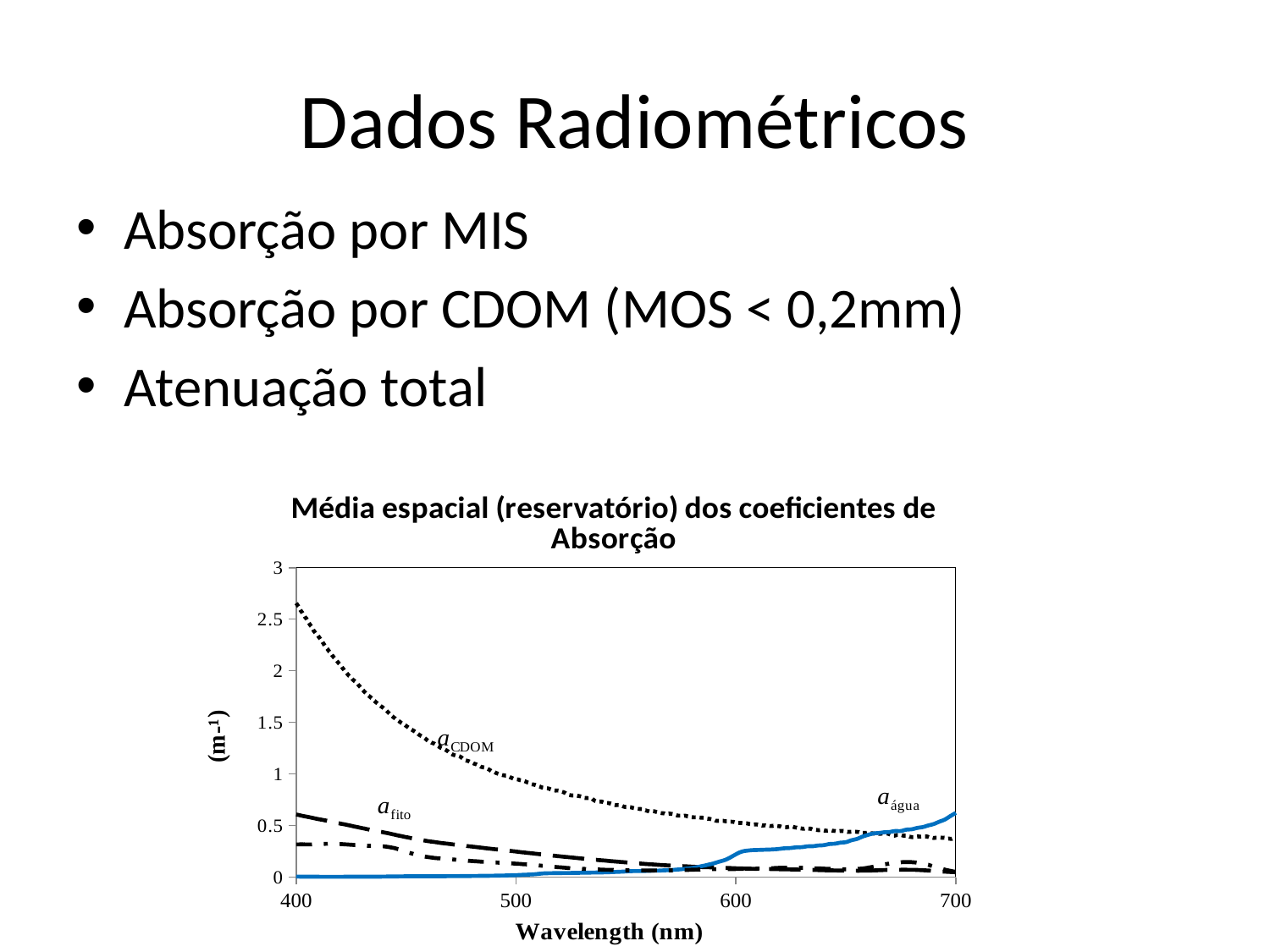
Which series has the highest value at 400 nm? a_CDOM Is the value of a_água at 700 nm greater or less than 0.5? greater What kind of chart is shown on the slide? line chart Is the value of a_CDOM at 400 nm greater or less than 2.5? greater Is the value of a_CDOM at 700 nm greater or less than 0.5? less Which series has the lowest value at 400 nm? a_água What is the title of the chart? Média espacial (reservatório) dos coeficientes de Absorção Does the a_água series rise or fall as wavelength increases from 400 to 700 nm? rise Does the a_CDOM series rise or fall as wavelength increases from 400 to 700 nm? fall What is the label of the x axis of the chart? Wavelength (nm) At 400 nm, which is larger: a_CDOM or a_fito? a_CDOM